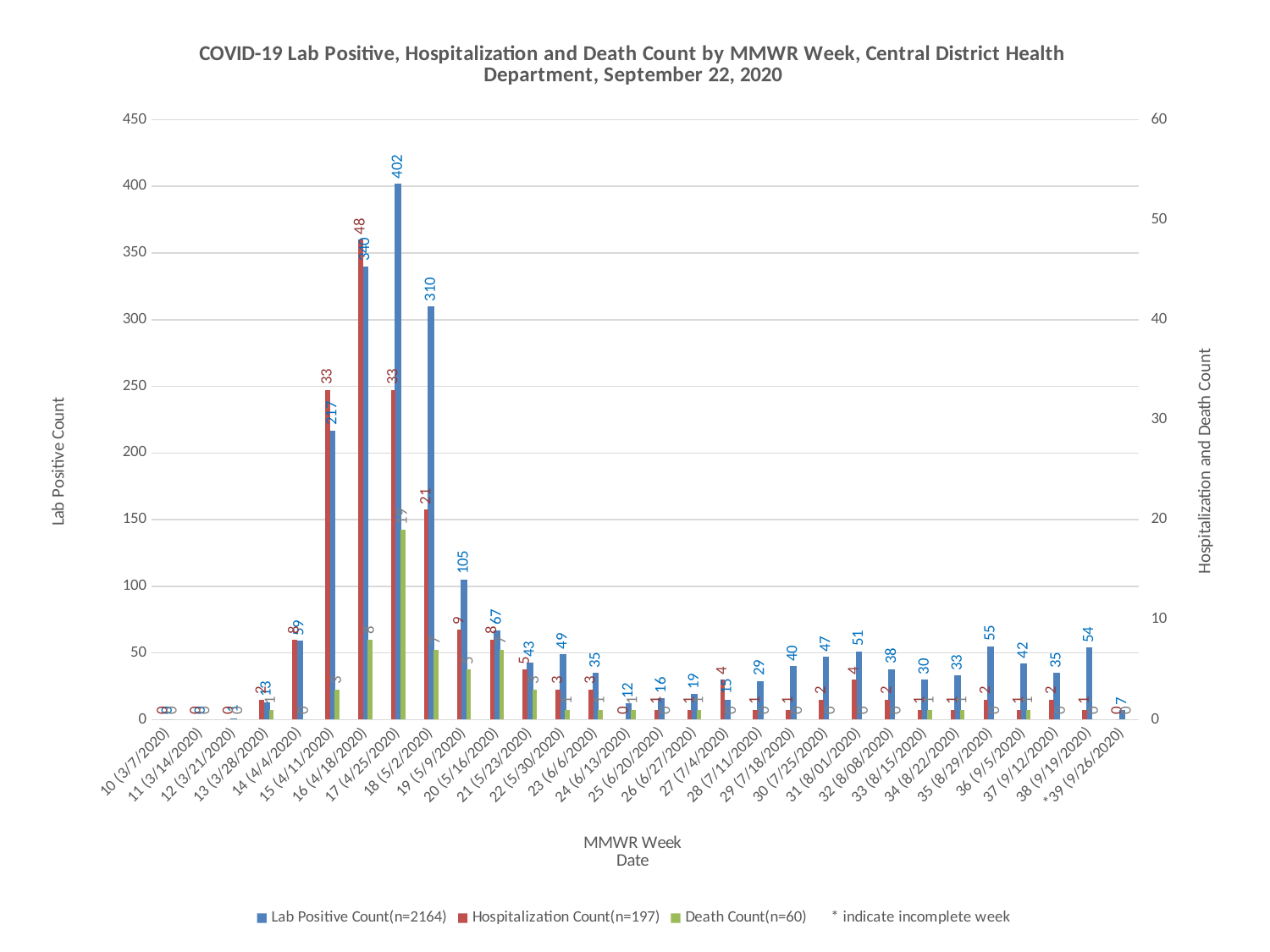
What is the Death Count for MMWR week 17 (4/25/2020)? 19 What is the difference between the Lab Positive Count in week 17 (4/25/2020) and week 18 (5/2/2020)? 92 What kind of chart is shown on the slide? Bar chart Which MMWR week has the highest Hospitalization Count? 16 (4/18/2020) What is the Lab Positive Count for MMWR week 18 (5/2/2020)? 310 Which MMWR week has the highest Lab Positive Count? 17 (4/25/2020) How many MMWR weeks are shown on the x axis? 30 Does the Lab Positive Count rise or fall from week 17 (4/25/2020) to week 24 (6/13/2020)? Fall How many series does the legend list? 3 Which has a larger Lab Positive Count, week 15 (4/11/2020) or week 18 (5/2/2020)? 18 (5/2/2020) What is the Hospitalization Count for MMWR week 16 (4/18/2020)? 48 What is the Lab Positive Count for MMWR week 17 (4/25/2020)? 402